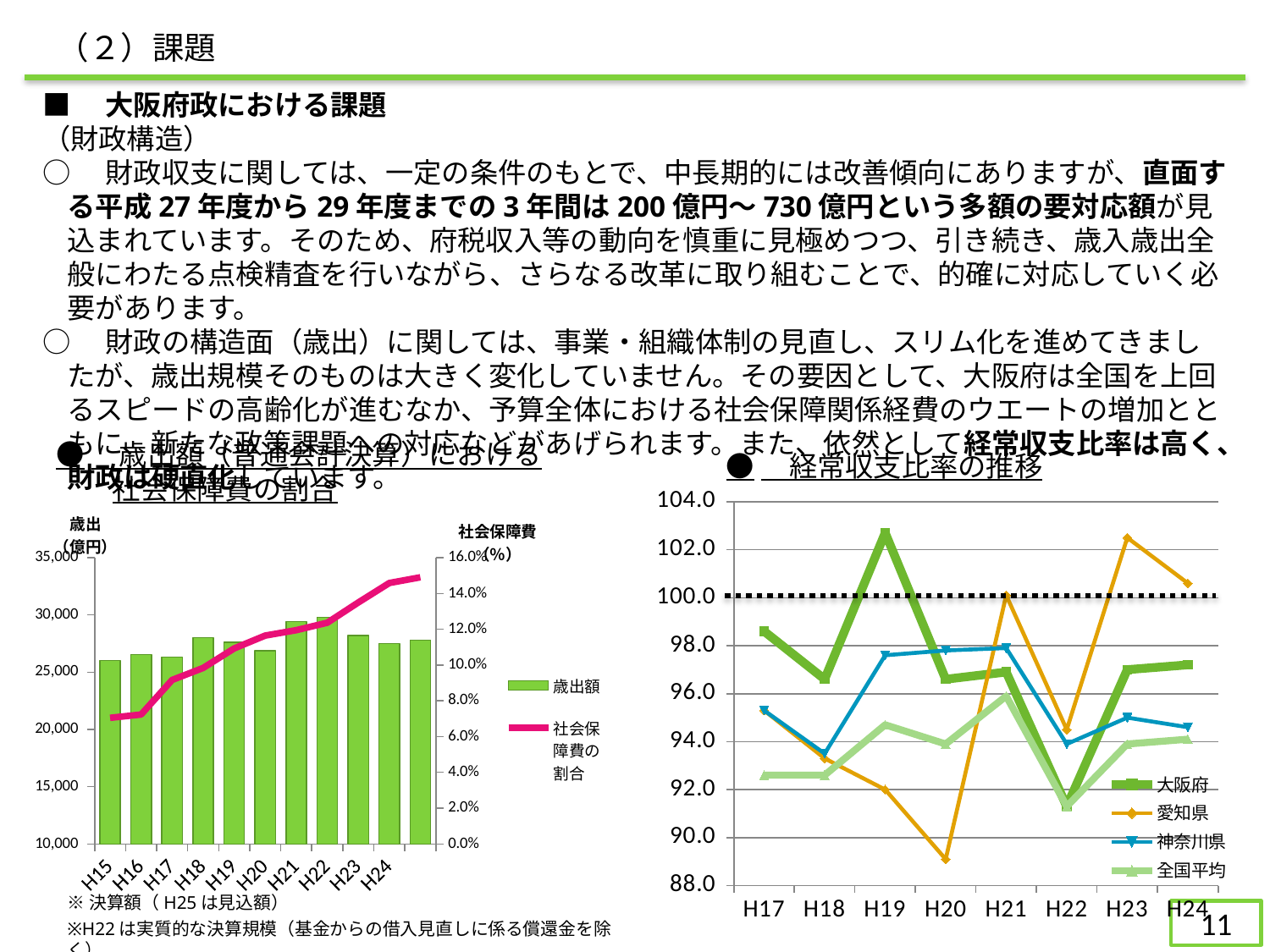
In the left chart (歳出額における社会保障費の割合), does the 社会保障費の割合 line rise or fall from H15 to the last year? rise In the chart titled 経常収支比率の推移, how many series does the legend list? 4 In the left chart (歳出額における社会保障費の割合), how many series does the legend list? 2 In the chart titled 経常収支比率の推移, how many years are shown on the x axis? 8 In the chart titled 経常収支比率の推移, which is larger in H23: 大阪府 or 愛知県? 愛知県 In the chart titled 経常収支比率の推移, in which year is the value for 愛知県 lowest? H20 In the chart titled 経常収支比率の推移, is the value for 大阪府 in H19 greater or less than 102.0? greater In the chart titled 経常収支比率の推移, in which year is the value for 大阪府 highest? H19 In the chart titled 経常収支比率の推移, is the value for 愛知県 in H20 greater or less than 90.0? less In the chart titled 経常収支比率の推移, which is larger in H17: 大阪府 or 全国平均? 大阪府 What kind of chart is the chart titled 経常収支比率の推移? line chart In the left chart (歳出額における社会保障費の割合), is the 社会保障費の割合 value for H15 greater or less than 8.0%? less